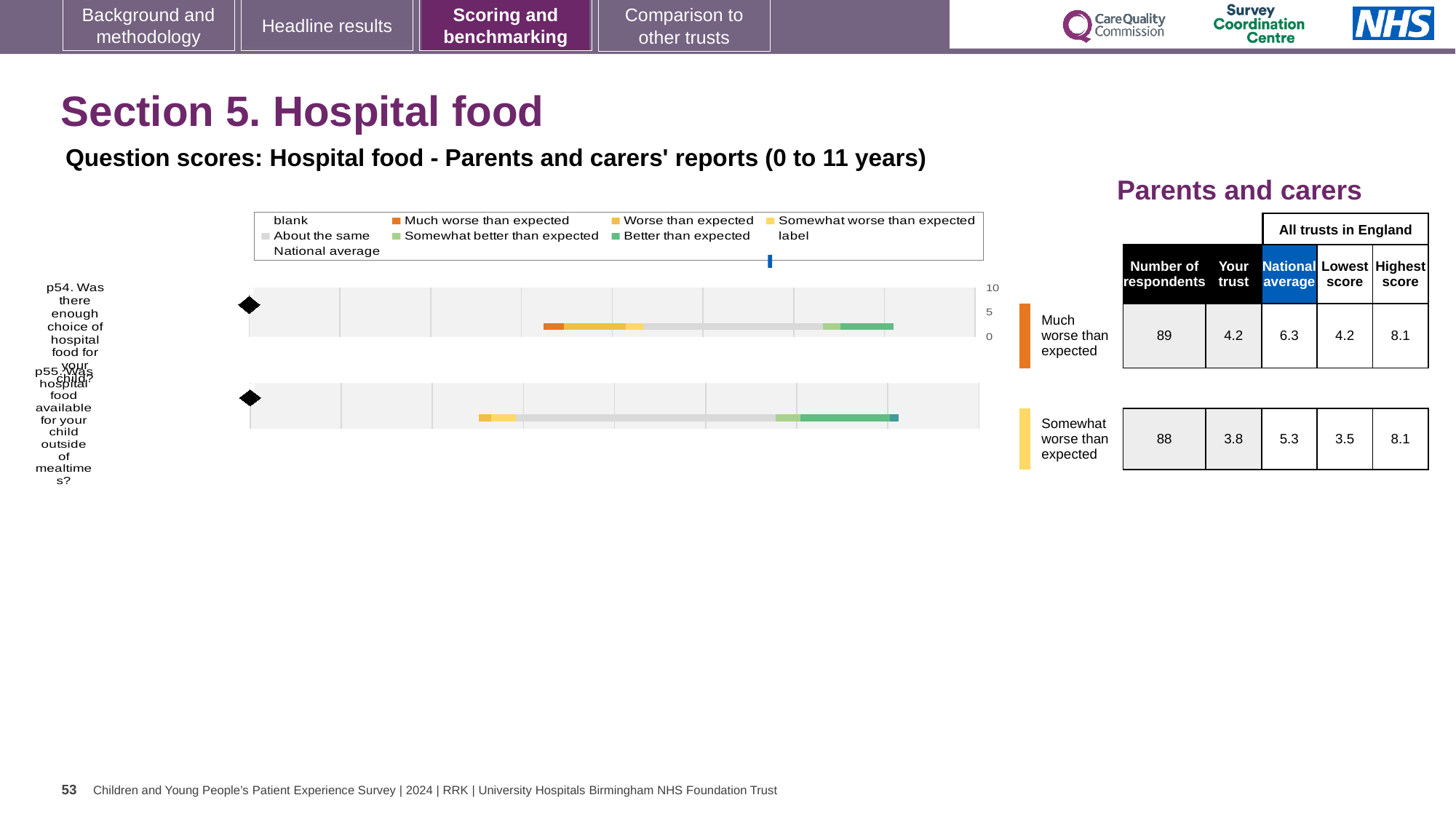
Is the 'Your trust' score for p55 greater or less than 5? less What kind of chart is used to show the question scores for hospital food? bar chart How many questions (categories) are plotted in the hospital food chart? 2 What is the lowest score among all trusts in England for p55? 3.5 What is the 'Your trust' score for p54 (enough choice of hospital food for your child)? 4.2 What is the highest score among all trusts in England for p54? 8.1 How many respondents answered p55? 88 Which benchmark category is p54 rated as? Much worse than expected Which question has the higher 'Your trust' score, p54 or p55? p54 By how much is the national average higher than the 'Your trust' score for p54? 2.1 What is the national average score for p55 (hospital food available outside of mealtimes)? 5.3 What is the difference between the highest and lowest scores for p55? 4.6